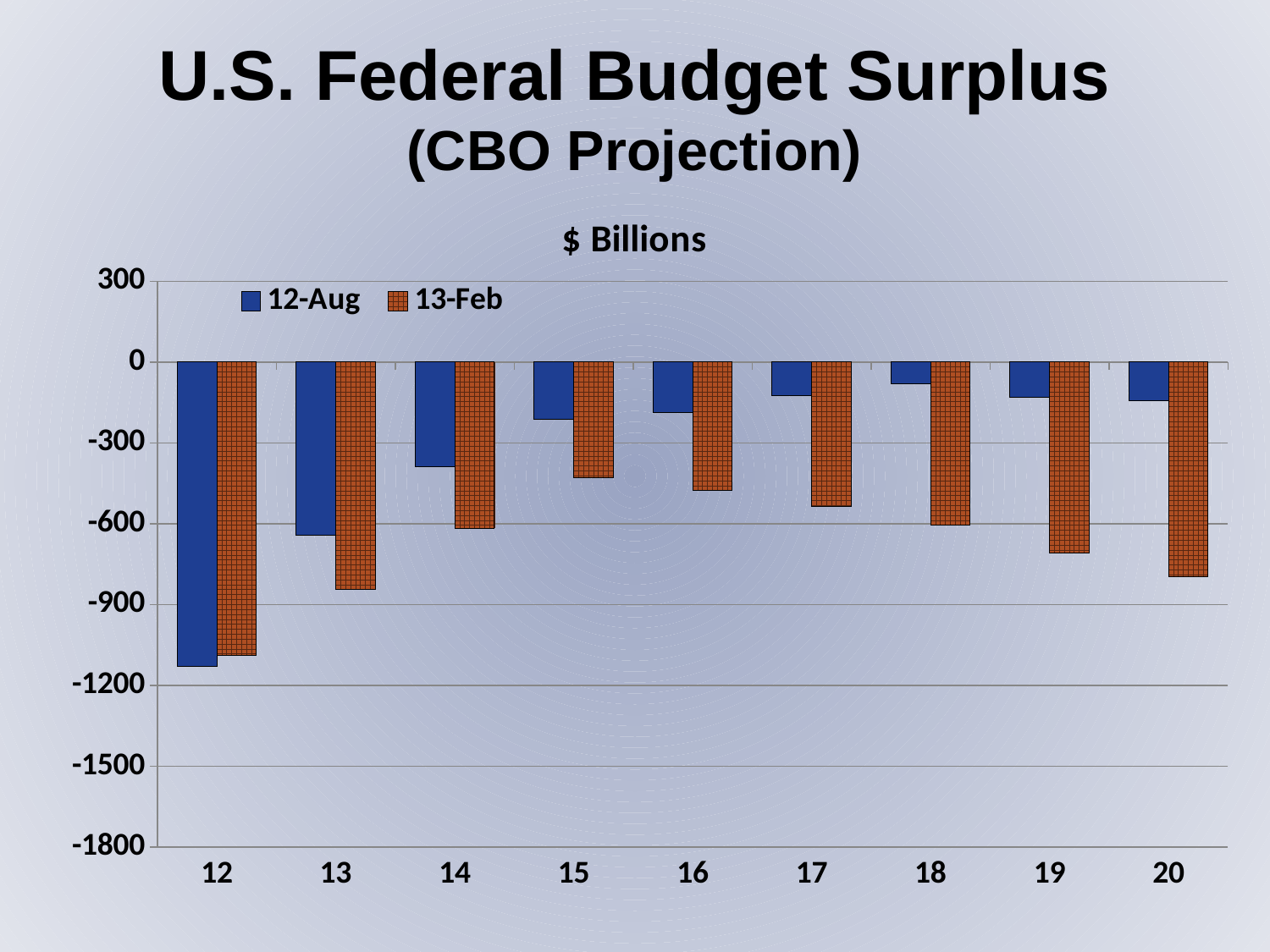
How many years are shown along the x axis? 9 Which year has the highest (closest to zero) value for the 12-Aug series? 18 Which year has the lowest (most negative) value for the 12-Aug series? 12 Which year has the lowest (most negative) value for the 13-Feb series? 12 Is the value for 12-Aug in year 13 greater or less than -600? less What kind of chart is shown on the slide? bar chart How many series does the legend list? 2 What unit label is shown above the chart? $ Billions Is the value for 13-Feb in year 13 greater or less than -900? greater What are the two series named in the legend? 12-Aug and 13-Feb In year 18, which series has the higher value, 12-Aug or 13-Feb? 12-Aug Do the 13-Feb values rise or fall from year 15 to year 20? fall